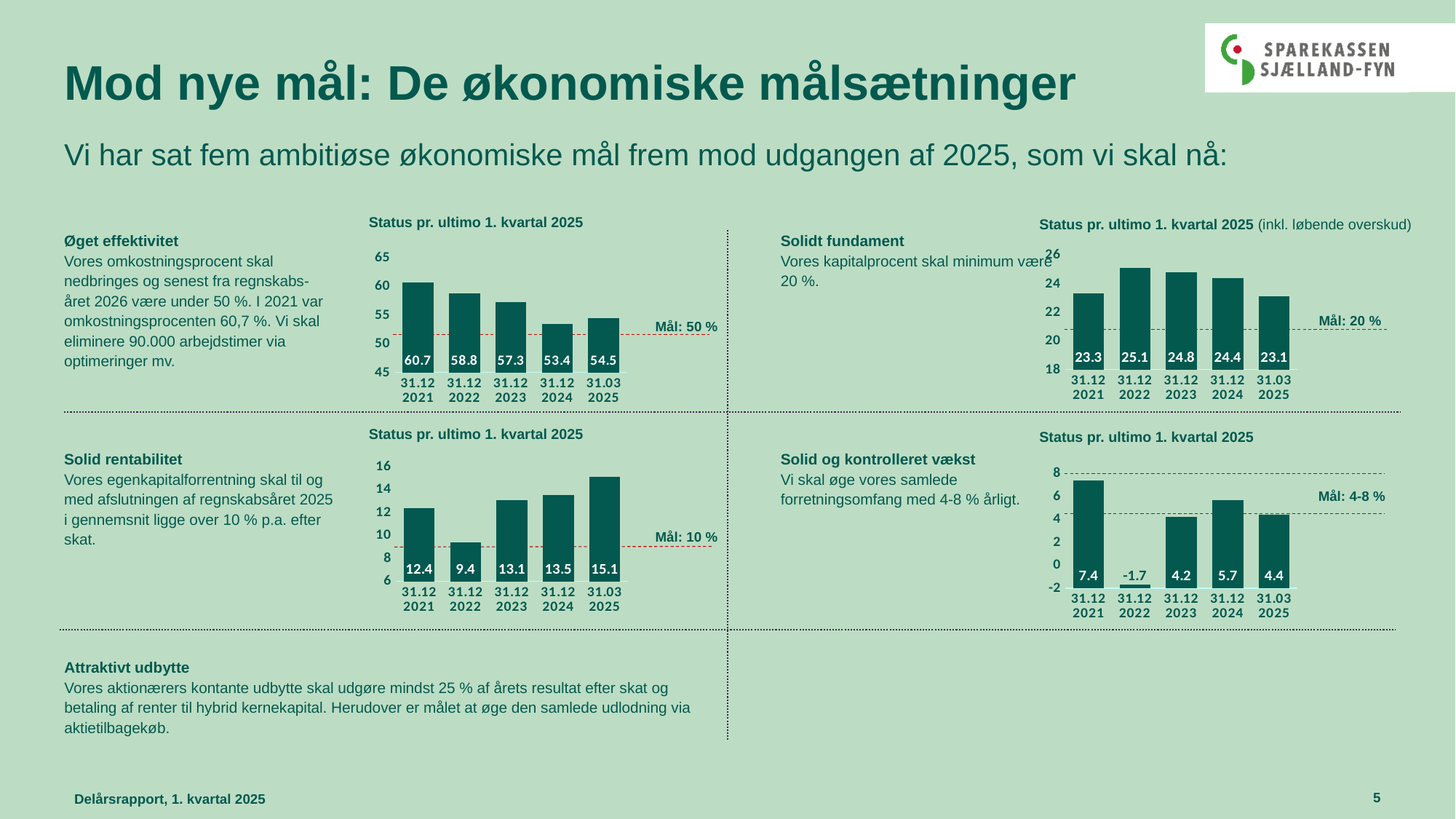
In the top-left chart (Øget effektivitet), what is the difference between the values for 31.12 2021 and 31.03 2025? 6.2 In the top-right chart (Solidt fundament), which date has the highest value? 31.12 2022 In the bottom-left chart (Solid rentabilitet), what is the value for 31.12 2022? 9.4 In the top-right chart (Solidt fundament), what target (Mål) is shown by the dashed line? Mål: 20 % In the bottom-right chart (Solid og kontrolleret vækst), what is the difference between the values for 31.12 2021 and 31.12 2024? 1.7 In the top-left chart (Øget effektivitet), what is the value for 31.12 2021? 60.7 In the top-left chart (Øget effektivitet), which date has the lowest value? 31.12 2024 In the top-right chart (Solidt fundament), what is the value for 31.03 2025? 23.1 In the bottom-right chart (Solid og kontrolleret vækst), what is the value for 31.12 2022? -1.7 How many bars does the bottom-right chart (Solid og kontrolleret vækst) show? 5 In the bottom-left chart (Solid rentabilitet), is the value for 31.12 2024 larger or smaller than the value for 31.12 2023? larger In the bottom-left chart (Solid rentabilitet), which date has the highest value? 31.03 2025